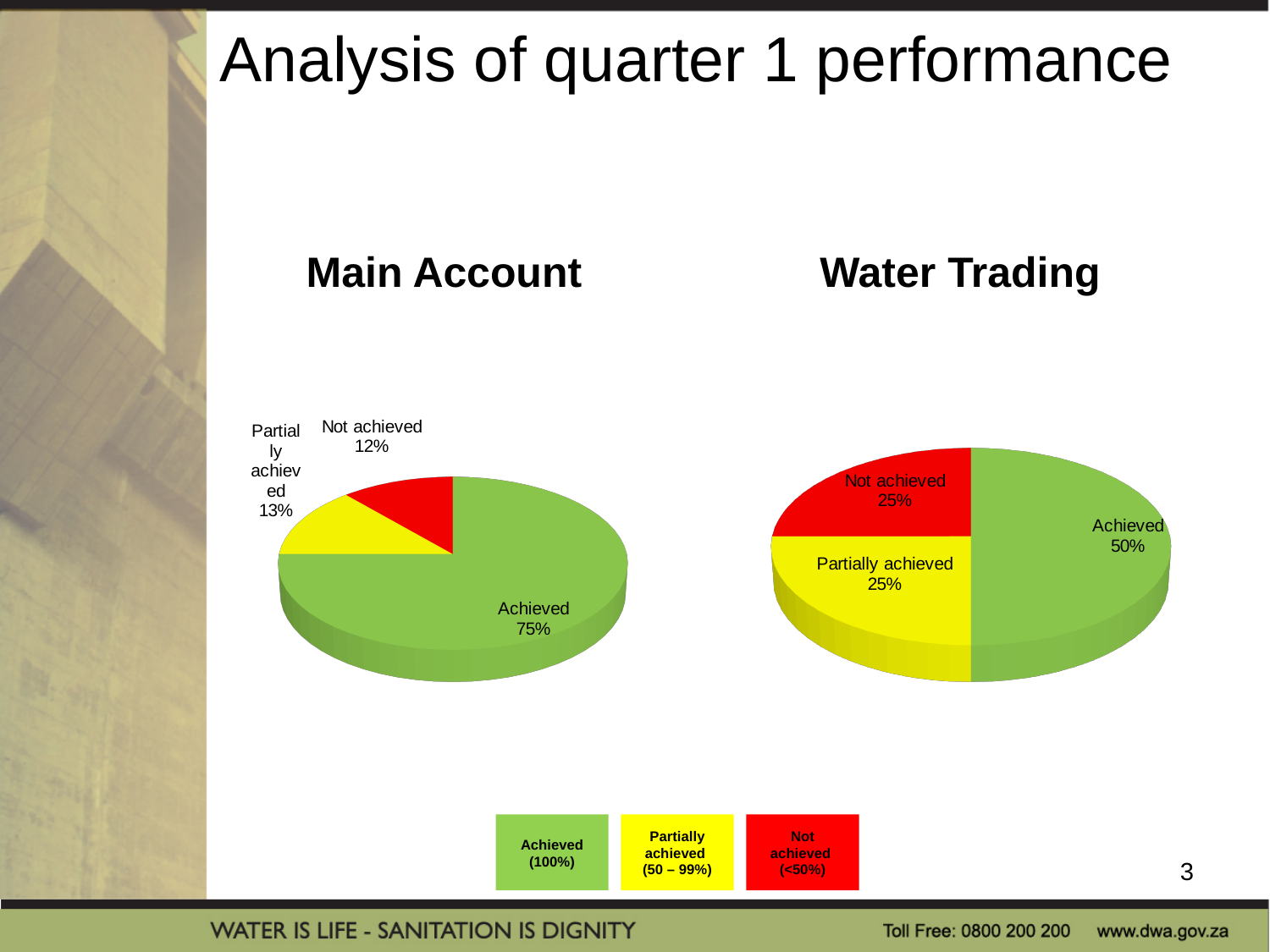
In the Main Account chart, what share of the pie is Partially achieved? 13% What is the difference between the Achieved share in the Main Account chart and the Achieved share in the Water Trading chart? 25% In the Main Account chart, what share of the pie is Not achieved? 12% In the Water Trading chart, what share of the pie is Achieved? 50% In the Main Account chart, which category has the largest slice? Achieved In the Water Trading chart, which category has the largest slice? Achieved In the Main Account chart, which is larger: Partially achieved or Not achieved? Partially achieved What kind of chart is the Main Account chart? Pie chart How many slices does the Water Trading chart have? 3 In the Main Account chart, which category has the smallest slice? Not achieved